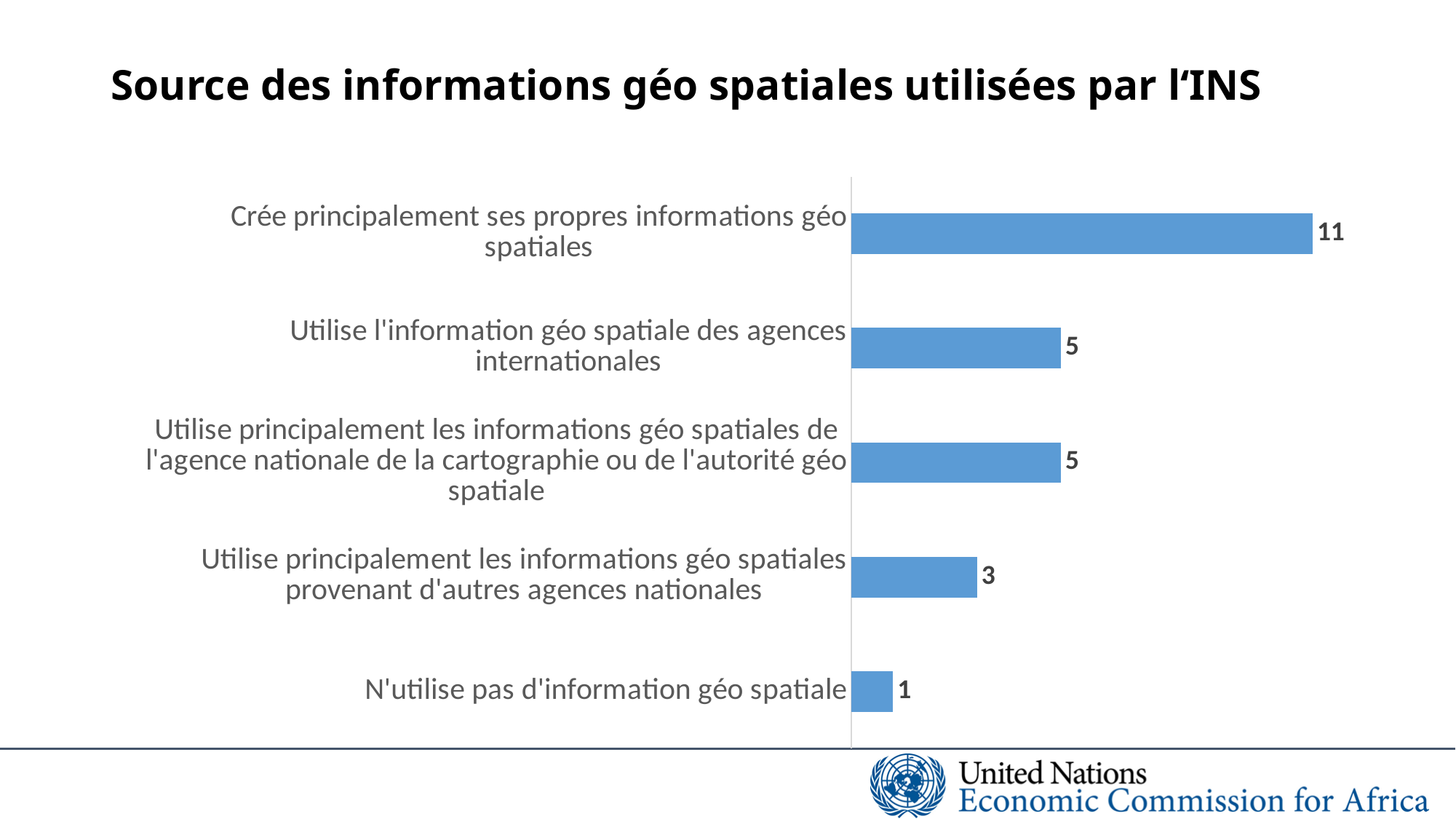
What is the title of the chart? Source des informations géo spatiales utilisées par l'INS What kind of chart is shown on the slide? Bar chart What is the value for "Crée principalement ses propres informations géo spatiales"? 11 What is the value for "N'utilise pas d'information géo spatiale"? 1 What is the difference between the value for "Crée principalement ses propres informations géo spatiales" and the value for "Utilise l'information géo spatiale des agences internationales"? 6 What is the value for "Utilise principalement les informations géo spatiales provenant d'autres agences nationales"? 3 How many categories are shown in the chart? 5 What is the difference between the value for "Utilise principalement les informations géo spatiales provenant d'autres agences nationales" and the value for "N'utilise pas d'information géo spatiale"? 2 Which category has the highest value? Crée principalement ses propres informations géo spatiales Which category has the lowest value? N'utilise pas d'information géo spatiale Which is larger: the value for "Crée principalement ses propres informations géo spatiales" or the value for "Utilise principalement les informations géo spatiales provenant d'autres agences nationales"? Crée principalement ses propres informations géo spatiales What is the value for "Utilise l'information géo spatiale des agences internationales"? 5